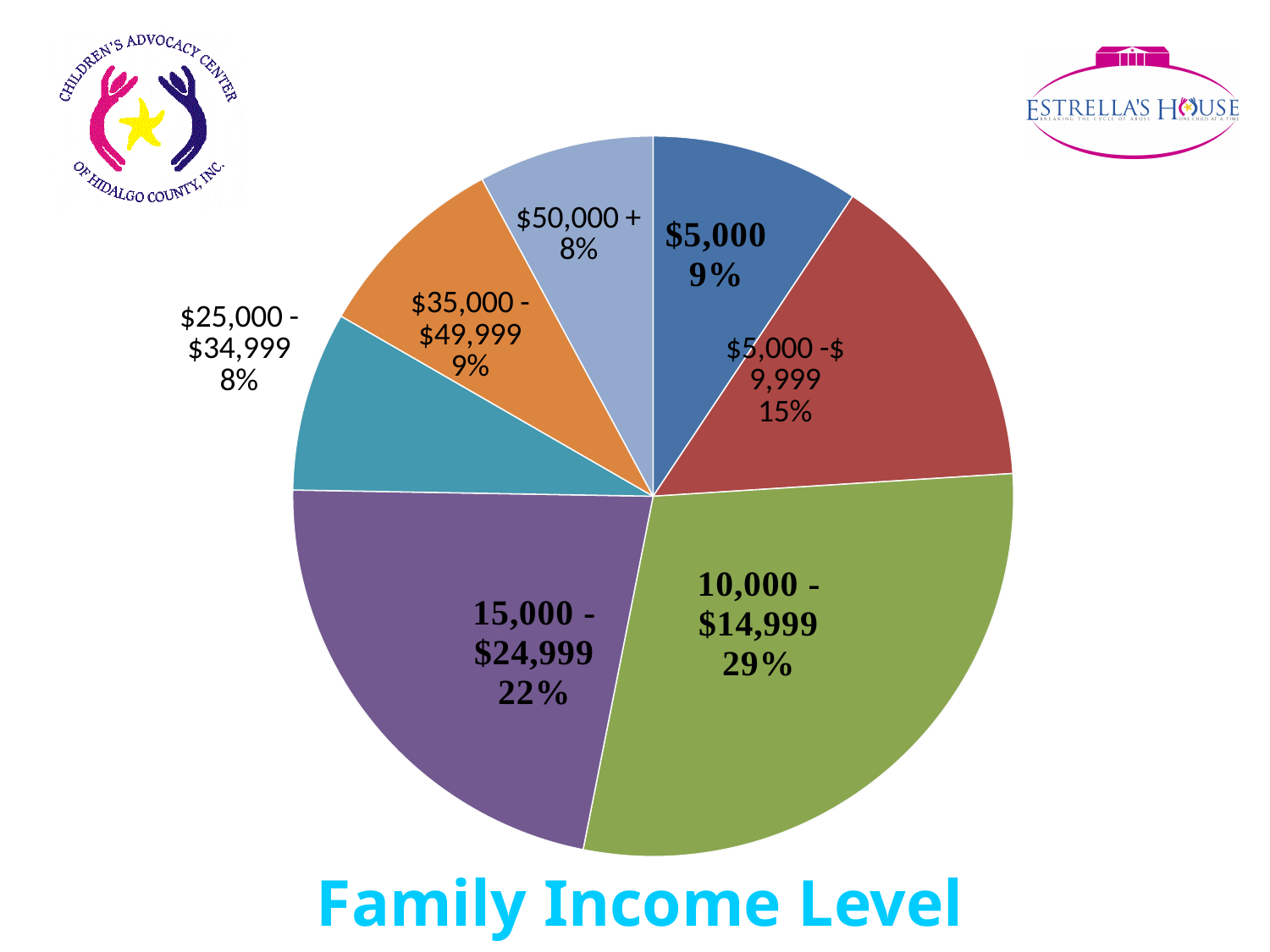
What percentage is shown for the $35,000 - $49,999 income level? 9% Which income level has the largest share of the pie? 10,000 - $14,999 What is the title of the chart? Family Income Level What percentage of families fall in the 10,000 - $14,999 income level? 29% What kind of chart is shown on the slide? Pie chart Which slice is larger: $5,000 - $9,999 or $25,000 - $34,999? $5,000 - $9,999 What colour is the slice for the 10,000 - $14,999 income level? Green What percentage is shown for the 15,000 - $24,999 income level? 22% How many slices does the pie chart have? 7 What percentage is shown for the $5,000 - $9,999 income level? 15% What is the difference in percentage points between the 10,000 - $14,999 slice and the 15,000 - $24,999 slice? 7 What percentage is shown for the $50,000 + income level? 8%